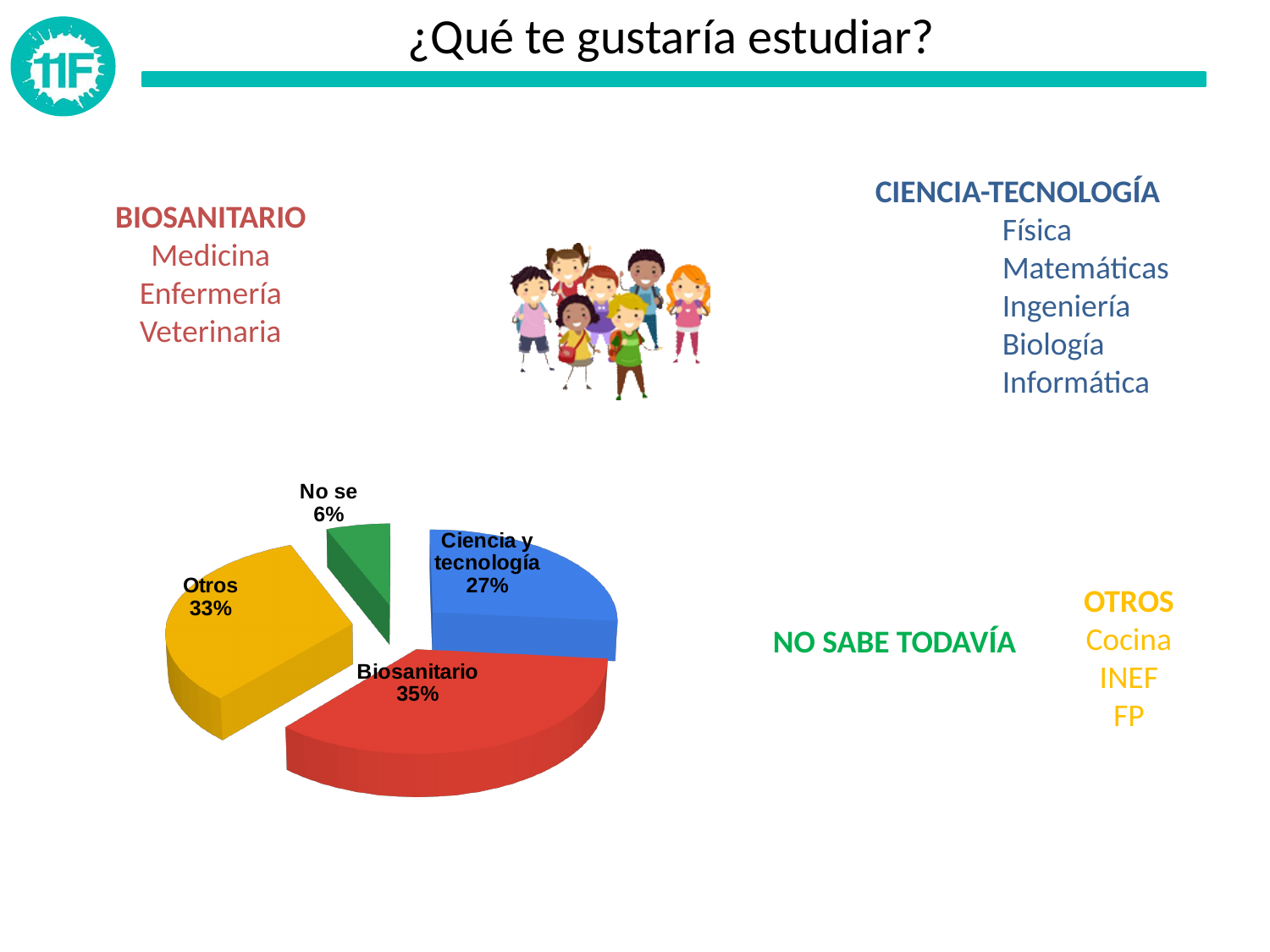
Which is larger in the pie chart, Otros or Ciencia y tecnología? Otros What colour is the Otros slice of the pie chart? Yellow What kind of chart is shown on the slide? Pie chart Which slice of the pie chart is the smallest? No se What is the difference in percentage points between Biosanitario and Ciencia y tecnología? 8 What colour is the Biosanitario slice of the pie chart? Red What percentage of the pie chart is Ciencia y tecnología? 27% Which slice of the pie chart is the largest? Biosanitario What percentage of the pie chart is Biosanitario? 35% What percentage of the pie chart is Otros? 33% What percentage of the pie chart is No se? 6% How many slices does the pie chart have? 4